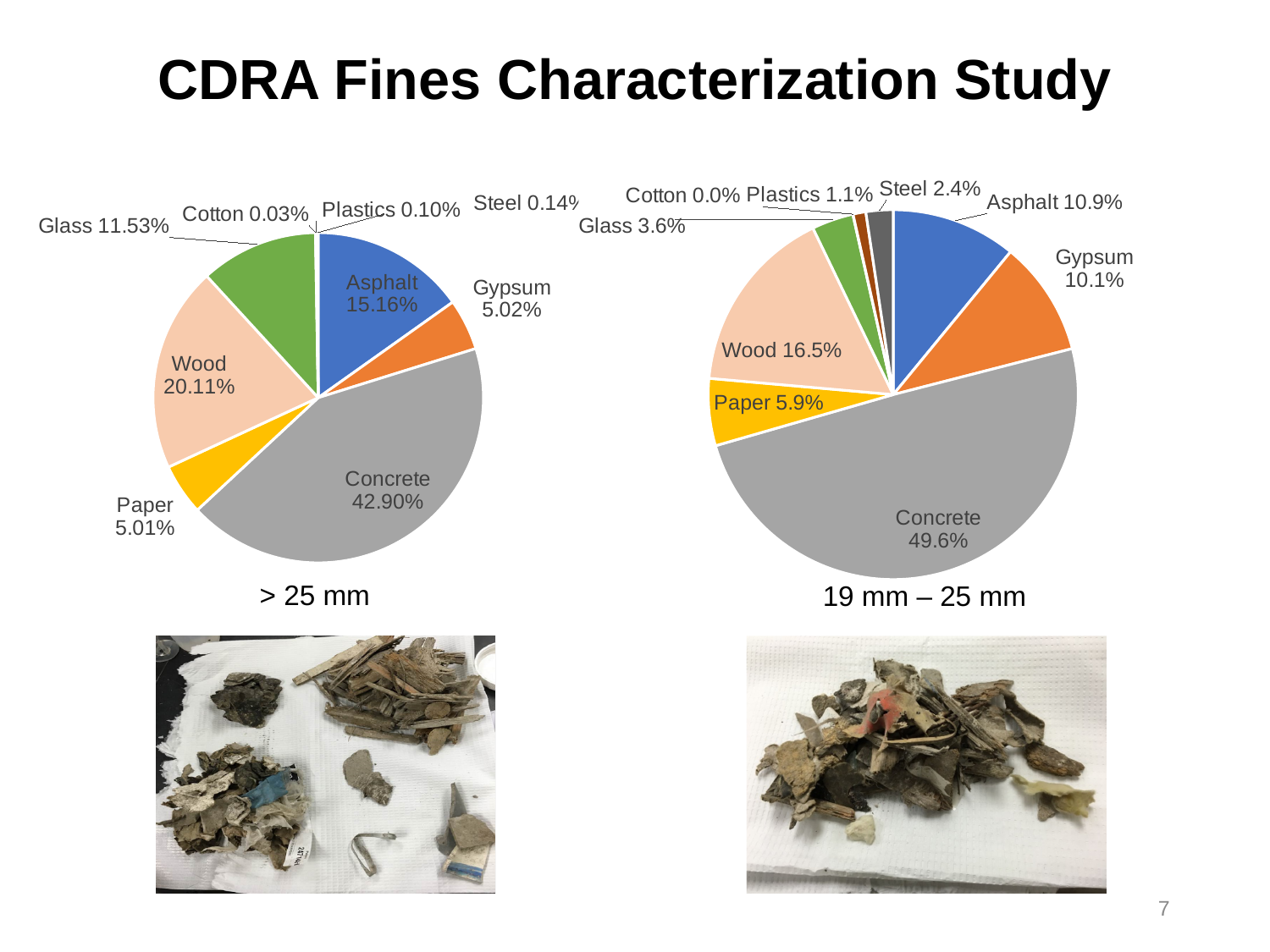
In the "> 25 mm" pie chart, which category has the largest slice? Concrete In the "19 mm – 25 mm" pie chart, what is the difference between the Concrete and Wood shares? 33.1% In the "> 25 mm" pie chart, which is larger, Wood or Asphalt? Wood In the "> 25 mm" pie chart, what is the value for Glass? 11.53% In the "> 25 mm" pie chart, which category has the smallest share? Cotton How many categories are shown in the "19 mm – 25 mm" pie chart? 9 In the "> 25 mm" pie chart, what share does Concrete have? 42.90% In the "19 mm – 25 mm" pie chart, which category has the smallest share? Cotton In the "19 mm – 25 mm" pie chart, what is the value for Steel? 2.4% What type of chart is used for the "> 25 mm" data? Pie chart In the "19 mm – 25 mm" pie chart, what share does Wood have? 16.5% What is the title of the slide containing the two pie charts? CDRA Fines Characterization Study